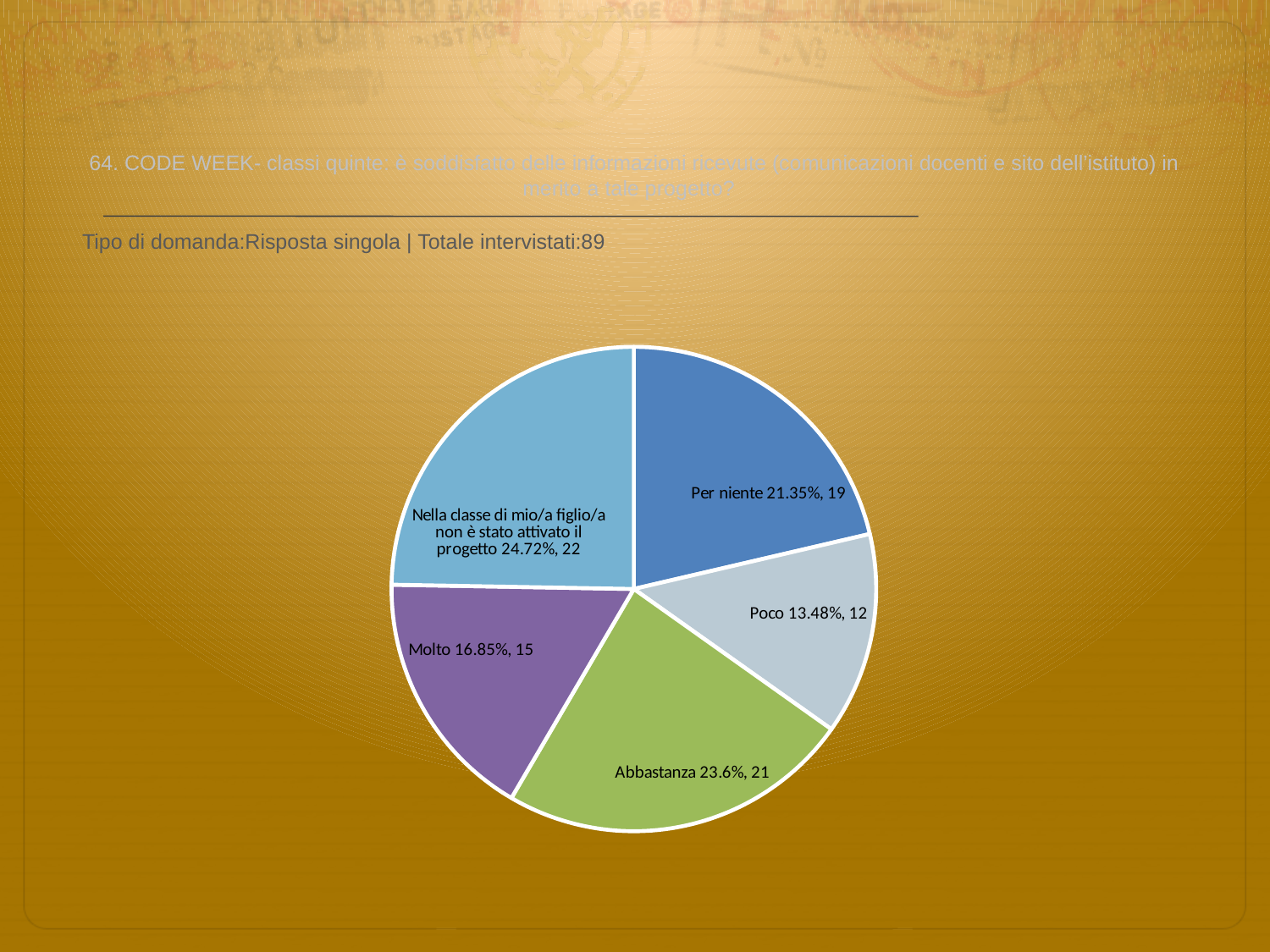
What is the difference in count between 'Per niente' and 'Poco'? 7 Which slice has the largest share of the pie? Nella classe di mio/a figlio/a non è stato attivato il progetto What is the total number of respondents (Totale intervistati) stated on the slide? 89 What percentage share does the 'Poco' slice have? 13.48% What colour is the 'Abbastanza' slice? green What percentage share does the 'Molto' slice have? 16.85% What is the count for the 'Abbastanza' slice? 21 How many slices does the pie chart have? 5 What is the count for the 'Per niente' slice? 19 Which slice has the smallest share of the pie? Poco What kind of chart is shown on the slide? pie chart Which has a larger count, 'Molto' or 'Abbastanza'? Abbastanza